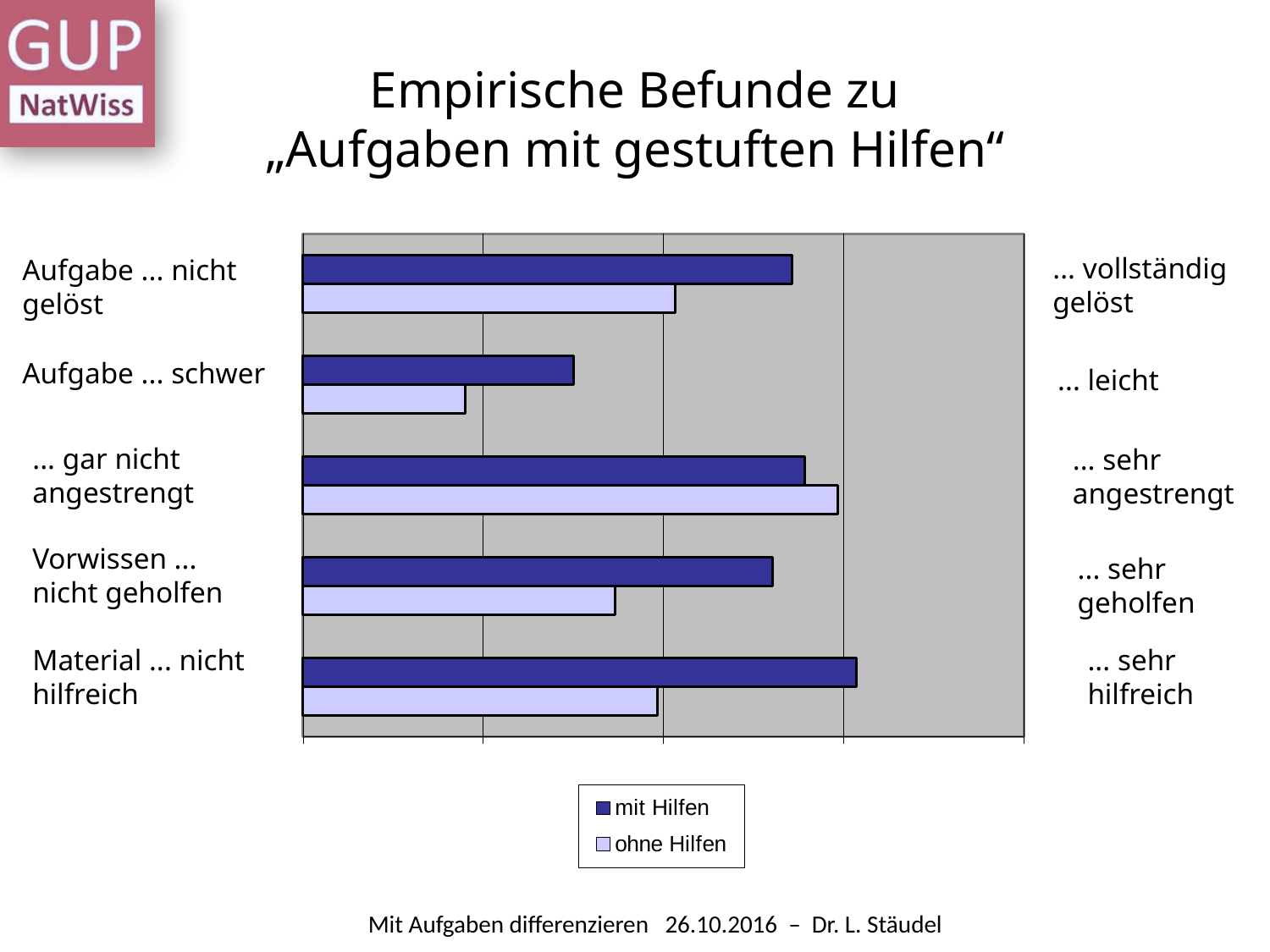
For "Material ... nicht hilfreich / ... sehr hilfreich", which series has the longer bar? mit Hilfen How many categories (pairs of bars) are plotted in the chart? 5 Which category has the longest bar for the "ohne Hilfen" series? ... gar nicht angestrengt / ... sehr angestrengt Which category has the shortest bar for the "mit Hilfen" series? Aufgabe ... schwer / ... leicht What are the two entries listed in the chart legend? mit Hilfen, ohne Hilfen What kind of chart is shown on the slide? bar chart Which series has the longest bar for the category "Aufgabe ... schwer / ... leicht", "mit Hilfen" or "ohne Hilfen"? mit Hilfen For "Aufgabe ... nicht gelöst / ... vollständig gelöst", which series has the longer bar? mit Hilfen Which category has the longest bar for the "mit Hilfen" series? Material ... nicht hilfreich / ... sehr hilfreich How many series does the legend list? 2 Which category has the shortest bar for the "ohne Hilfen" series? Aufgabe ... schwer / ... leicht